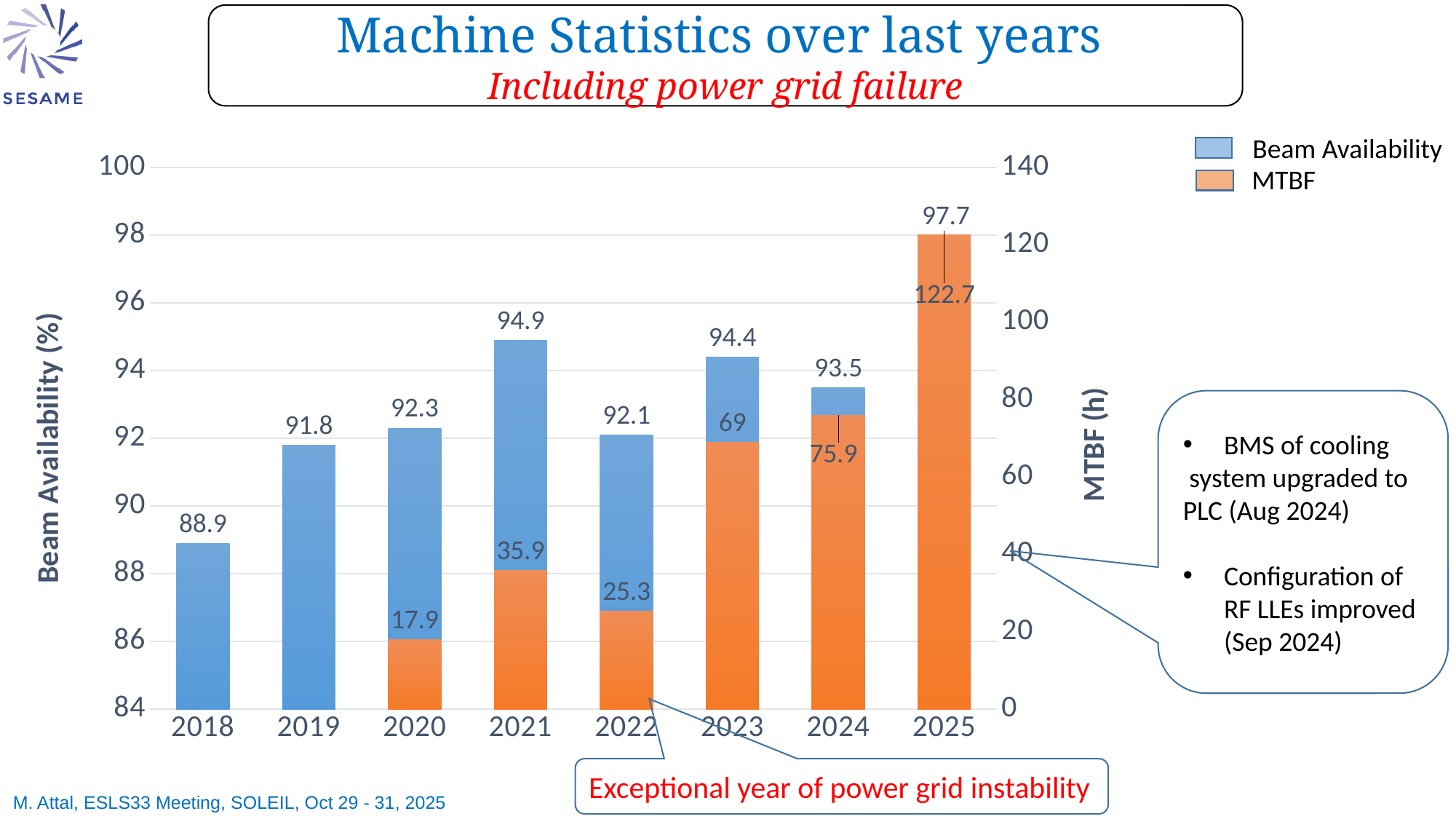
What is the MTBF value for 2020? 17.9 Which year has a higher MTBF, 2021 or 2022? 2021 How many years are shown on the x axis? 8 What is the MTBF value for 2024? 75.9 How many series does the legend list? 2 Which year has the highest Beam Availability? 2025 What is the difference between the Beam Availability in 2025 and in 2018? 8.8 Which year has the highest MTBF? 2025 What is the Beam Availability value for 2021? 94.9 Which year has the lowest Beam Availability? 2018 What kind of chart is shown on the slide? Bar chart What is the difference between the MTBF in 2025 and in 2024? 46.8